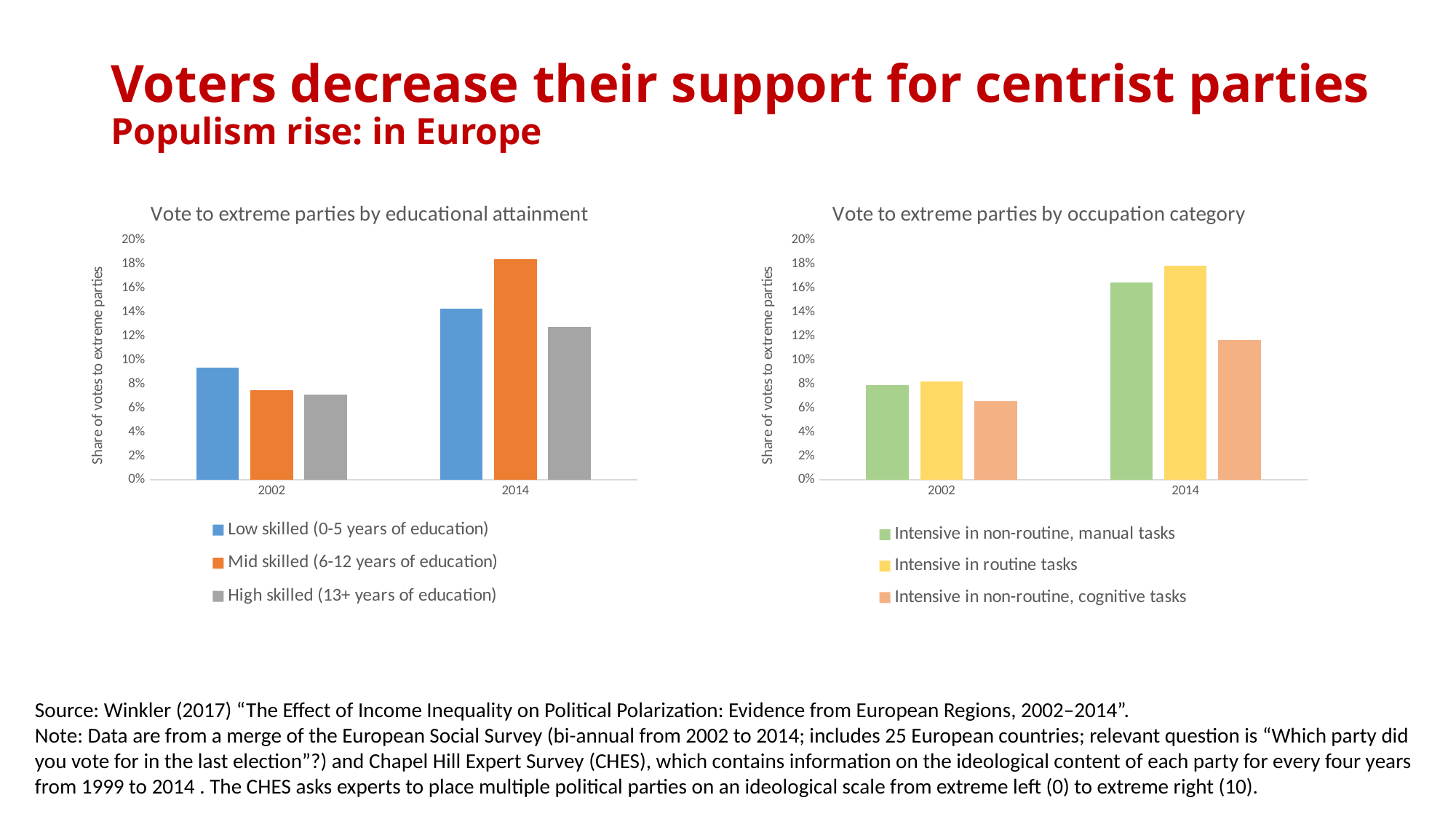
In the 'Vote to extreme parties by educational attainment' chart, is the value for Mid skilled in 2014 greater or less than 16%? greater In the 'Vote to extreme parties by educational attainment' chart, which series has the highest value in 2014? Mid skilled (6-12 years of education) In the 'Vote to extreme parties by occupation category' chart, how many series does the legend list? 3 In the 'Vote to extreme parties by occupation category' chart, which is larger in 2014: Intensive in routine tasks or Intensive in non-routine, cognitive tasks? Intensive in routine tasks In the 'Vote to extreme parties by occupation category' chart, how many years are shown on the x axis? 2 In the 'Vote to extreme parties by occupation category' chart, which series has the lowest value in 2014? Intensive in non-routine, cognitive tasks In the 'Vote to extreme parties by educational attainment' chart, how many series does the legend list? 3 In the 'Vote to extreme parties by educational attainment' chart, does the value for Low skilled rise or fall from 2002 to 2014? rise In the 'Vote to extreme parties by educational attainment' chart, which series has the highest value in 2002? Low skilled (0-5 years of education) What type of chart is the 'Vote to extreme parties by educational attainment' chart? bar chart In the 'Vote to extreme parties by occupation category' chart, is the value for Intensive in routine tasks in 2014 greater or less than 16%? greater In the 'Vote to extreme parties by educational attainment' chart, is the value for High skilled in 2002 greater or less than 8%? less